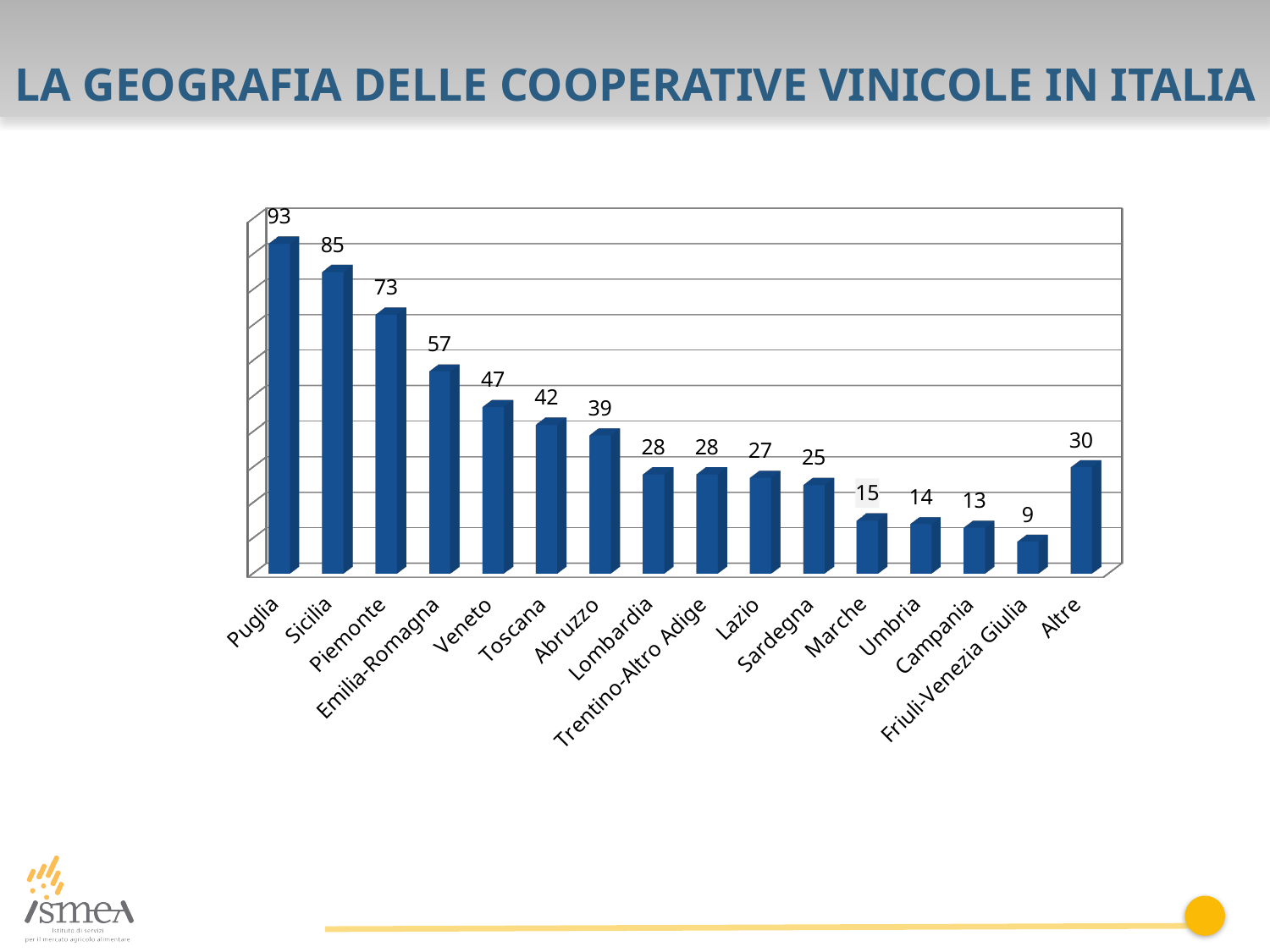
What is the value for Friuli-Venezia Giulia? 9 How many categories are shown on the x axis? 16 Which is larger, the value for Toscana or the value for Abruzzo? Toscana What is the value for Emilia-Romagna? 57 What is the difference between the values for Puglia and Sicilia? 8 What kind of chart is shown on the slide? Bar chart What is the difference between the values for Piemonte and Veneto? 26 What is the value for Altre? 30 What is the title of the slide? LA GEOGRAFIA DELLE COOPERATIVE VINICOLE IN ITALIA Which category has the lowest value? Friuli-Venezia Giulia Which category has the highest value? Puglia What is the value for Puglia? 93